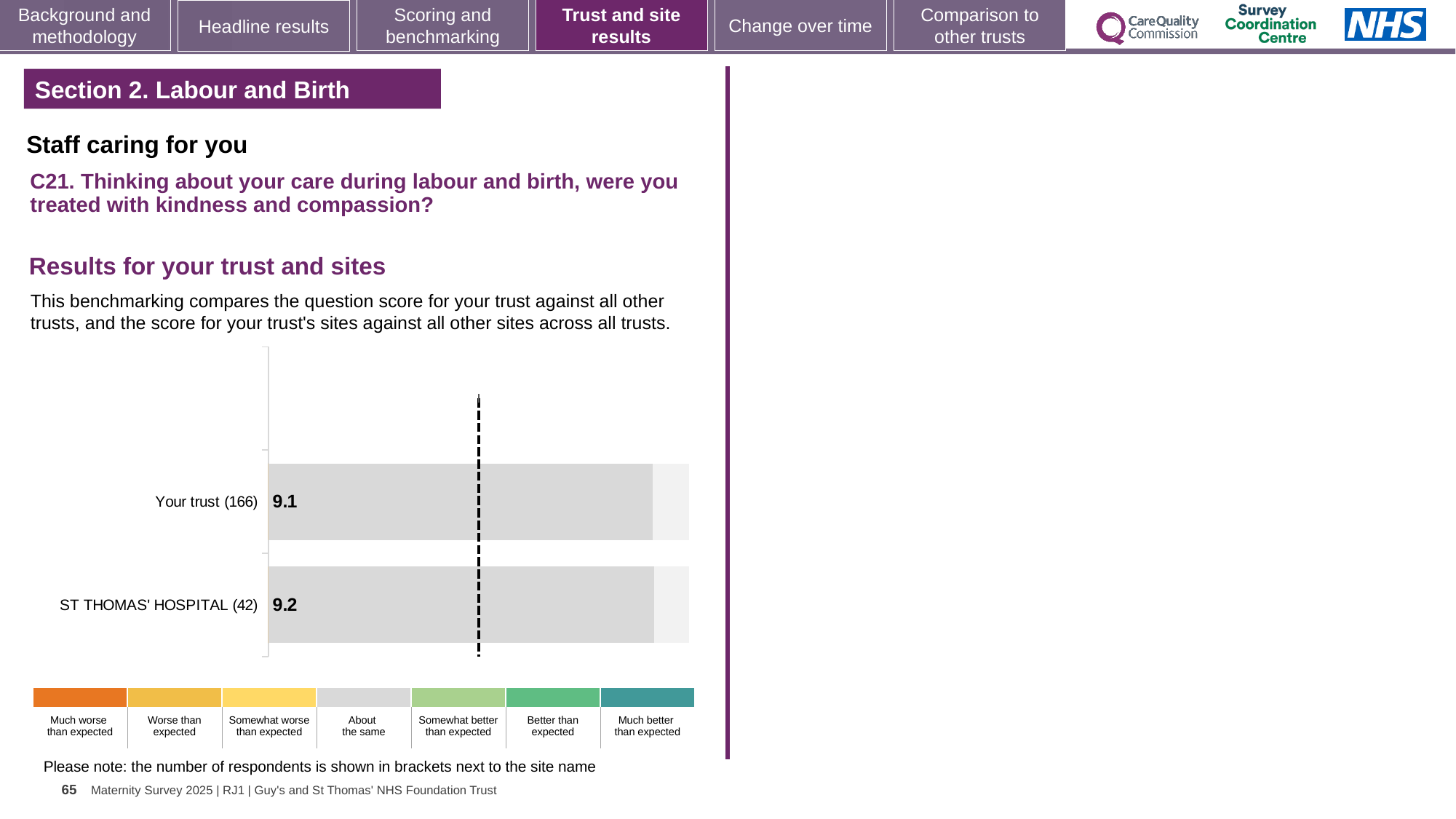
Which has the higher score, Your trust or ST THOMAS' HOSPITAL? ST THOMAS' HOSPITAL What kind of chart is shown on the slide? Bar chart Which bar in the chart has the lowest score? Your trust (166) How many bars are plotted in the chart? 2 Which survey question does the chart on the slide relate to? C21. Thinking about your care during labour and birth, were you treated with kindness and compassion? What is the score for ST THOMAS' HOSPITAL on question C21? 9.2 What is the difference between the score for ST THOMAS' HOSPITAL and the score for Your trust? 0.1 How many benchmark categories are listed in the colour key below the chart? 7 What is the score for Your trust on question C21? 9.1 Which bar in the chart has the highest score? ST THOMAS' HOSPITAL (42) How many respondents are shown in brackets for Your trust? 166 How many respondents are shown in brackets for ST THOMAS' HOSPITAL? 42